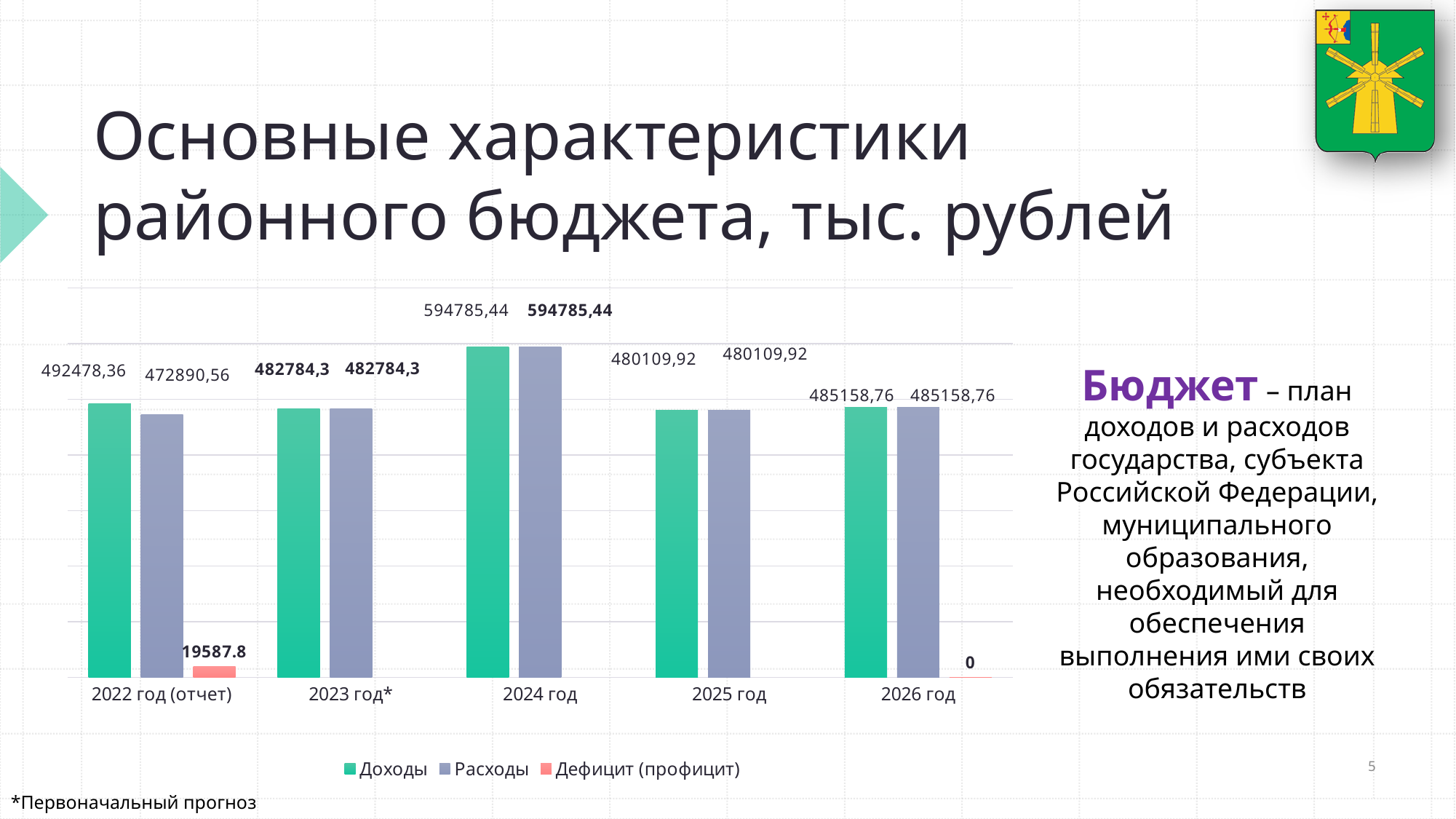
What is the value of Расходы for 2022 год (отчет)? 472890,56 What is the value of Доходы for 2024 год? 594785,44 What is the value of Доходы for 2022 год (отчет)? 492478,36 What is the difference between Доходы and Расходы for 2022 год (отчет)? 19587,8 How many series does the legend list? 3 Which year has the lowest value of Расходы? 2022 год (отчет) Which is larger for 2022 год (отчет): Доходы or Расходы? Доходы How many years are shown on the x axis of the chart? 5 What kind of chart is shown on the slide? Bar chart What is the value of Расходы for 2025 год? 480109,92 Which year has the highest value of Доходы? 2024 год What is the value of Дефицит (профицит) for 2022 год (отчет)? 19587.8